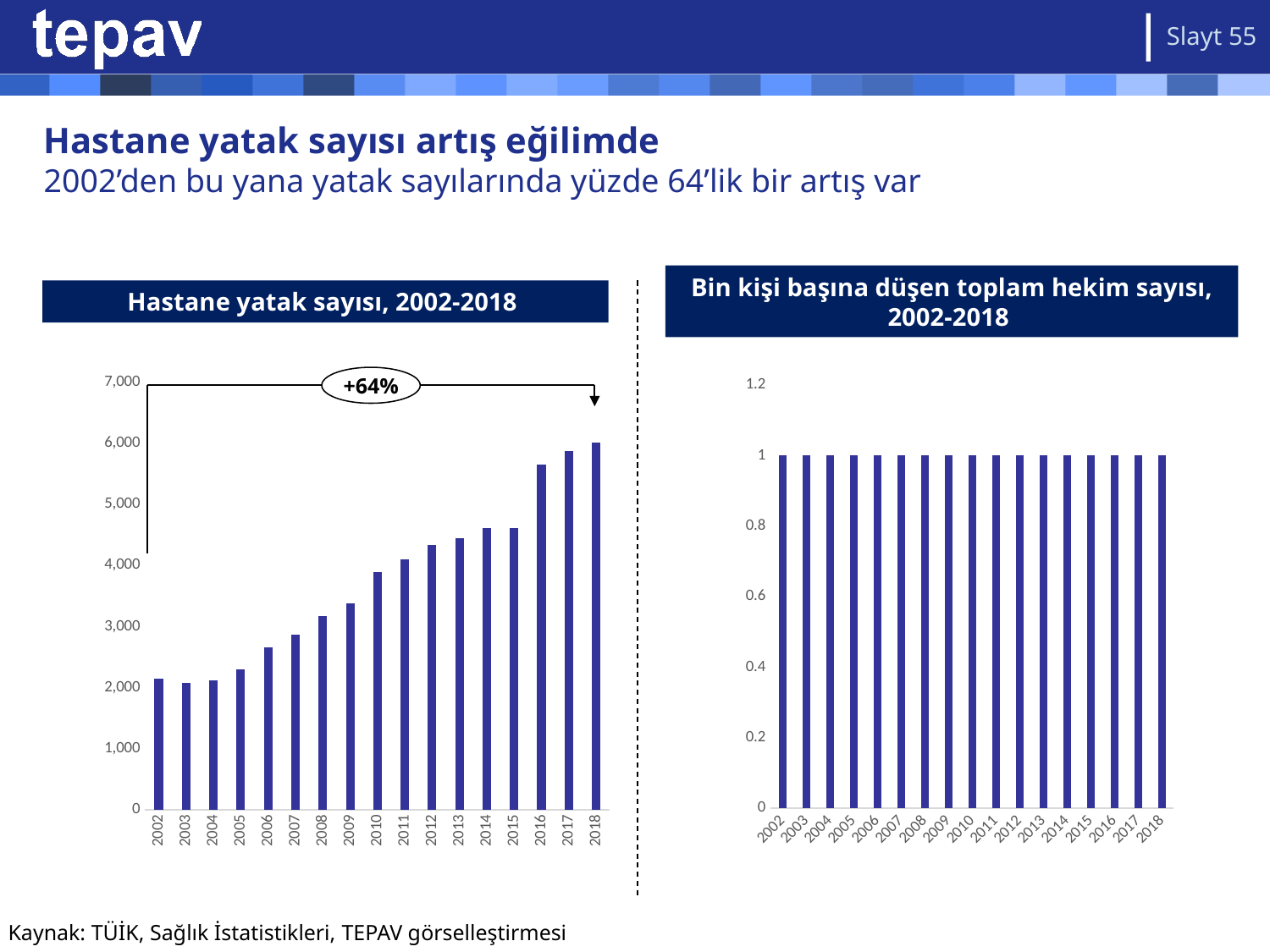
In the right chart "Bin kişi başına düşen toplam hekim sayısı, 2002-2018", what is the value for 2018? 1 What percentage increase is shown in the annotation on the left chart "Hastane yatak sayısı, 2002-2018"? +64% In the left chart "Hastane yatak sayısı, 2002-2018", which is larger, the value for 2012 or the value for 2006? 2012 In the right chart "Bin kişi başına düşen toplam hekim sayısı, 2002-2018", is the value for 2010 greater or less than 0.8? greater How many years are plotted in the left chart "Hastane yatak sayısı, 2002-2018"? 17 In the left chart "Hastane yatak sayısı, 2002-2018", is the value for 2002 greater or less than 3,000? less What kind of chart is the left chart titled "Hastane yatak sayısı, 2002-2018"? bar chart In the left chart "Hastane yatak sayısı, 2002-2018", is the value for 2009 greater or less than 4,000? less In the left chart "Hastane yatak sayısı, 2002-2018", do the values generally rise or fall from 2002 to 2018? rise What kind of chart is the right chart titled "Bin kişi başına düşen toplam hekim sayısı, 2002-2018"? bar chart In the left chart "Hastane yatak sayısı, 2002-2018", which year has the highest value? 2018